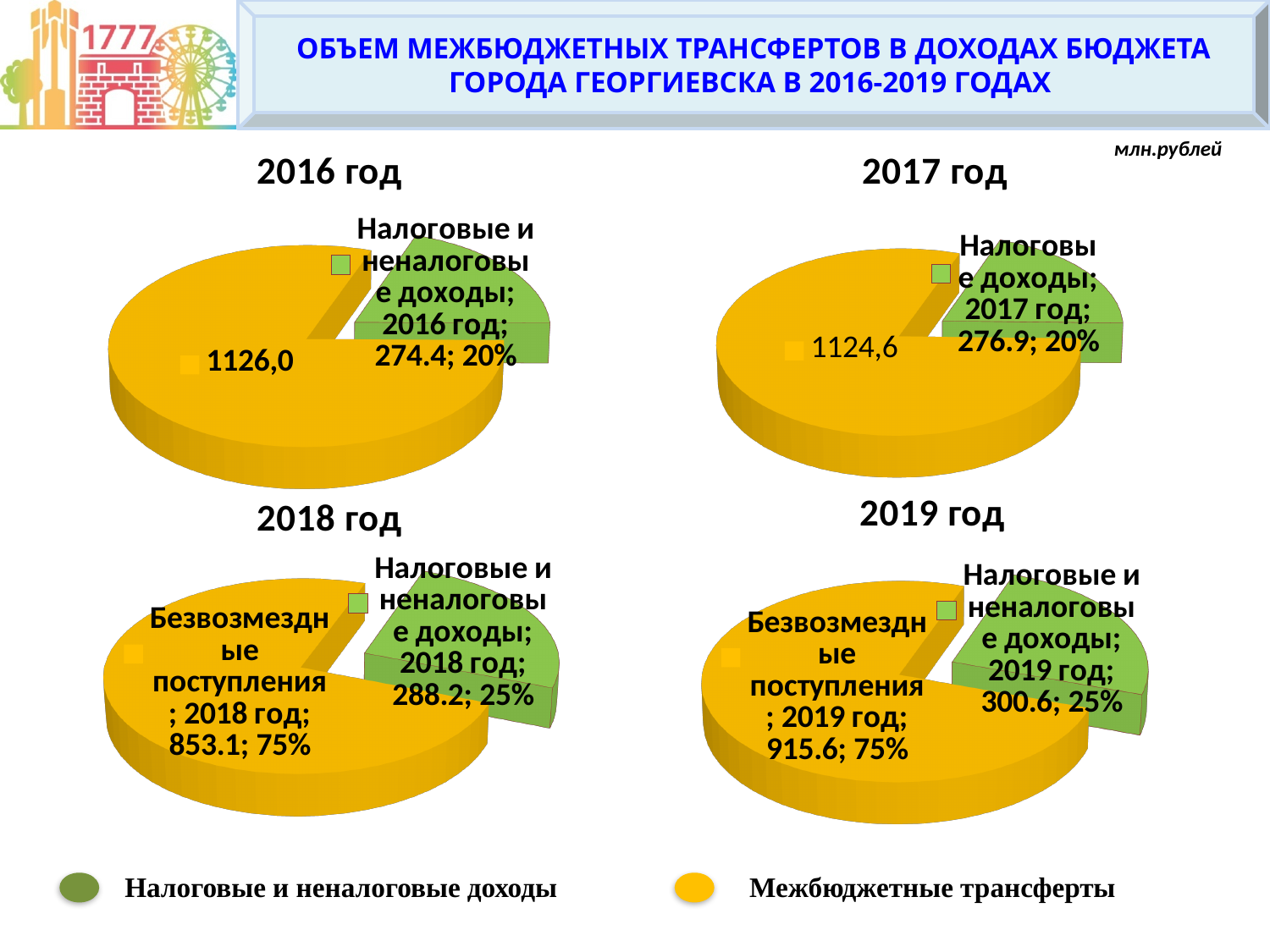
In the 2019 год chart, what value is shown for Налоговые и неналоговые доходы? 300.6 In the 2018 год chart, what value is shown for Безвозмездные поступления? 853.1 In the 2018 год chart, what is the difference between Безвозмездные поступления and Налоговые и неналоговые доходы? 564.9 In the 2019 год chart, which slice is larger, Безвозмездные поступления or Налоговые и неналоговые доходы? Безвозмездные поступления In the 2017 год chart, what share of the pie is Налоговые доходы? 20% In the 2016 год chart, what value is shown for Налоговые и неналоговые доходы? 274.4 In the 2016 год chart, what value is shown for the yellow slice? 1126,0 In the 2017 год chart, what value is shown for the yellow slice? 1124,6 In the 2019 год chart, what share of the pie is Безвозмездные поступления? 75% How many pie charts are shown on the slide? 4 What kind of chart is used for each year on the slide? Pie chart In the 2018 год chart, what share of the pie is Налоговые и неналоговые доходы? 25%